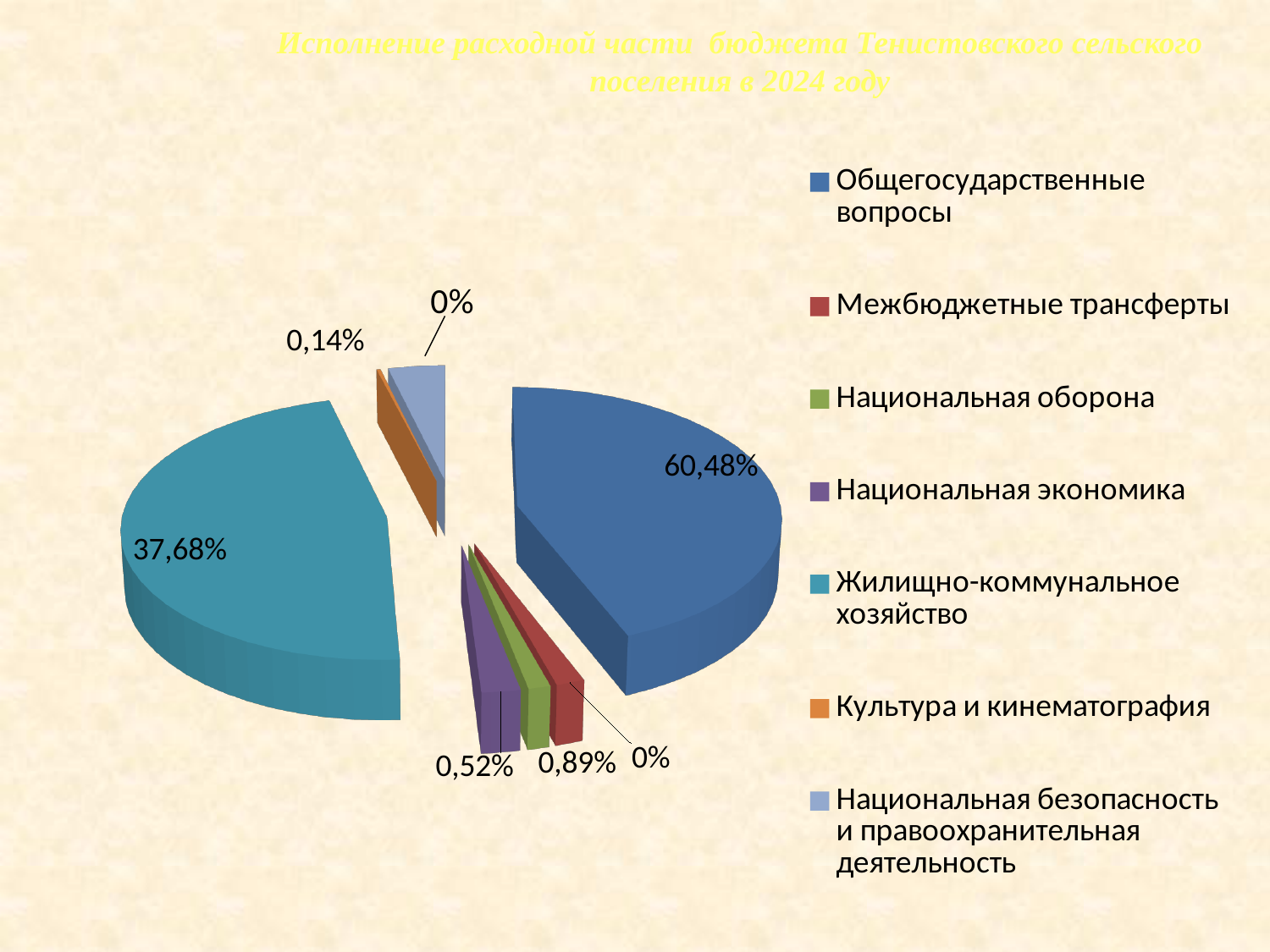
How many categories does the legend list? 7 What share of the pie does Культура и кинематография have? 0,14% What type of chart is shown on the slide? pie chart What share of the pie does Национальная экономика have? 0,52% What share of the pie does Национальная оборона have? 0,89% What is the difference between the shares of Общегосударственные вопросы and Жилищно-коммунальное хозяйство? 22,80% Which category has the largest slice of the pie? Общегосударственные вопросы What share of the pie does Общегосударственные вопросы have? 60,48% Which is larger, the slice for Национальная оборона or the slice for Национальная экономика? Национальная оборона What colour is the slice for Жилищно-коммунальное хозяйство? teal What share of the pie does Межбюджетные трансферты have? 0% What share of the pie does Жилищно-коммунальное хозяйство have? 37,68%